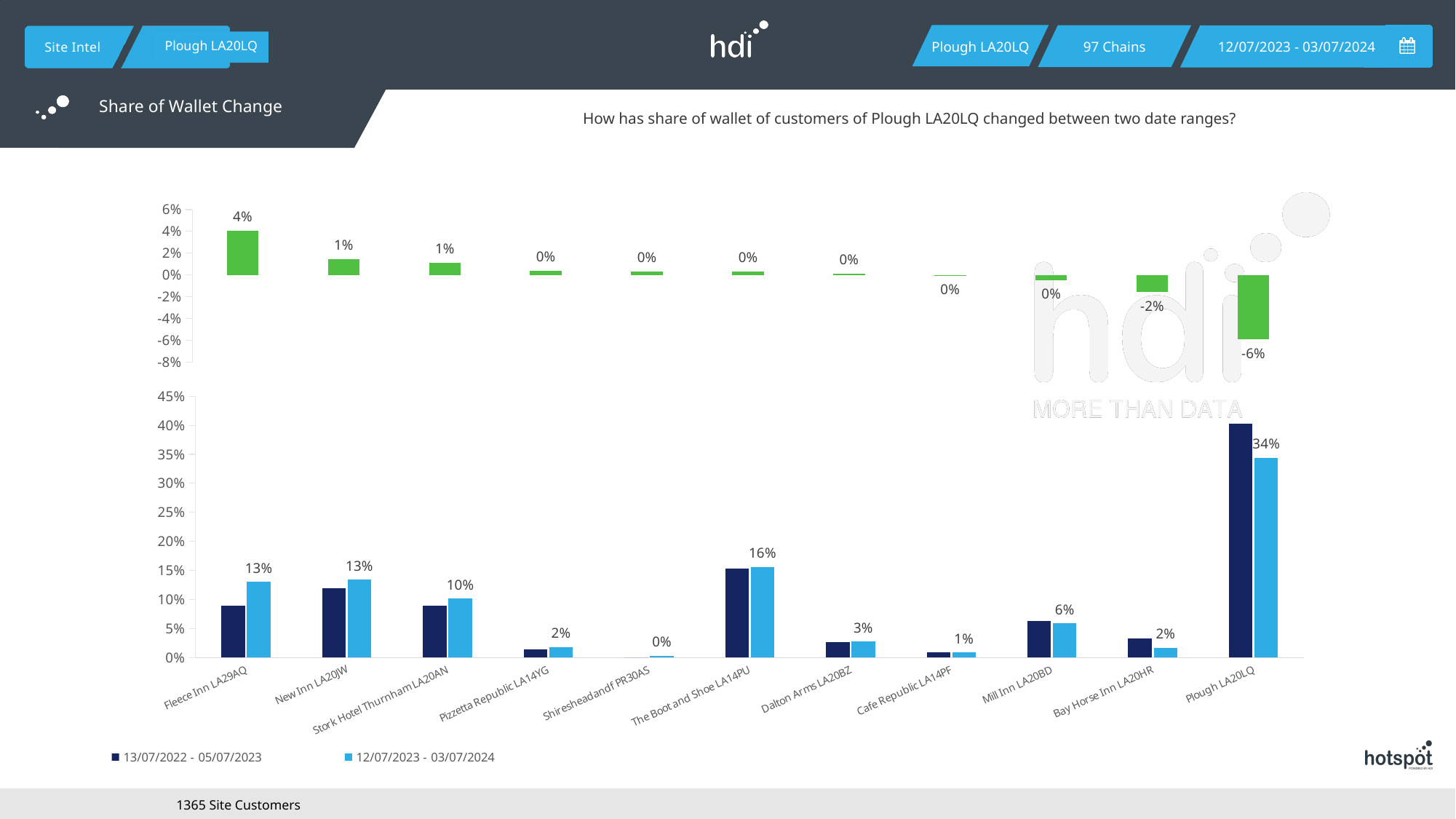
In the bottom chart, is the 13/07/2022 - 05/07/2023 value for Plough LA20LQ greater or less than 35%? greater In the bottom chart, what is the share of wallet for Plough LA20LQ in the 12/07/2023 - 03/07/2024 period? 34% In the bottom chart, what is the share of wallet for The Boot and Shoe LA14PU in the 12/07/2023 - 03/07/2024 period? 16% In the top chart, what is the share of wallet change for Plough LA20LQ? -6% In the bottom chart, is the 12/07/2023 - 03/07/2024 share of wallet larger for Mill Inn LA20BD or Dalton Arms LA20BZ? Mill Inn LA20BD In the top chart, which category has the lowest share of wallet change? Plough LA20LQ In the bottom chart, what is the difference between the 12/07/2023 - 03/07/2024 share of wallet for Plough LA20LQ and The Boot and Shoe LA14PU? 18% In the top chart, what is the share of wallet change for Fleece Inn LA29AQ? 4% How many series does the legend of the bottom chart list? 2 In the bottom chart, which category has the highest share of wallet in the 12/07/2023 - 03/07/2024 period? Plough LA20LQ What kind of chart is the bottom chart? Bar chart How many categories are shown on the x axis of the bottom chart? 11